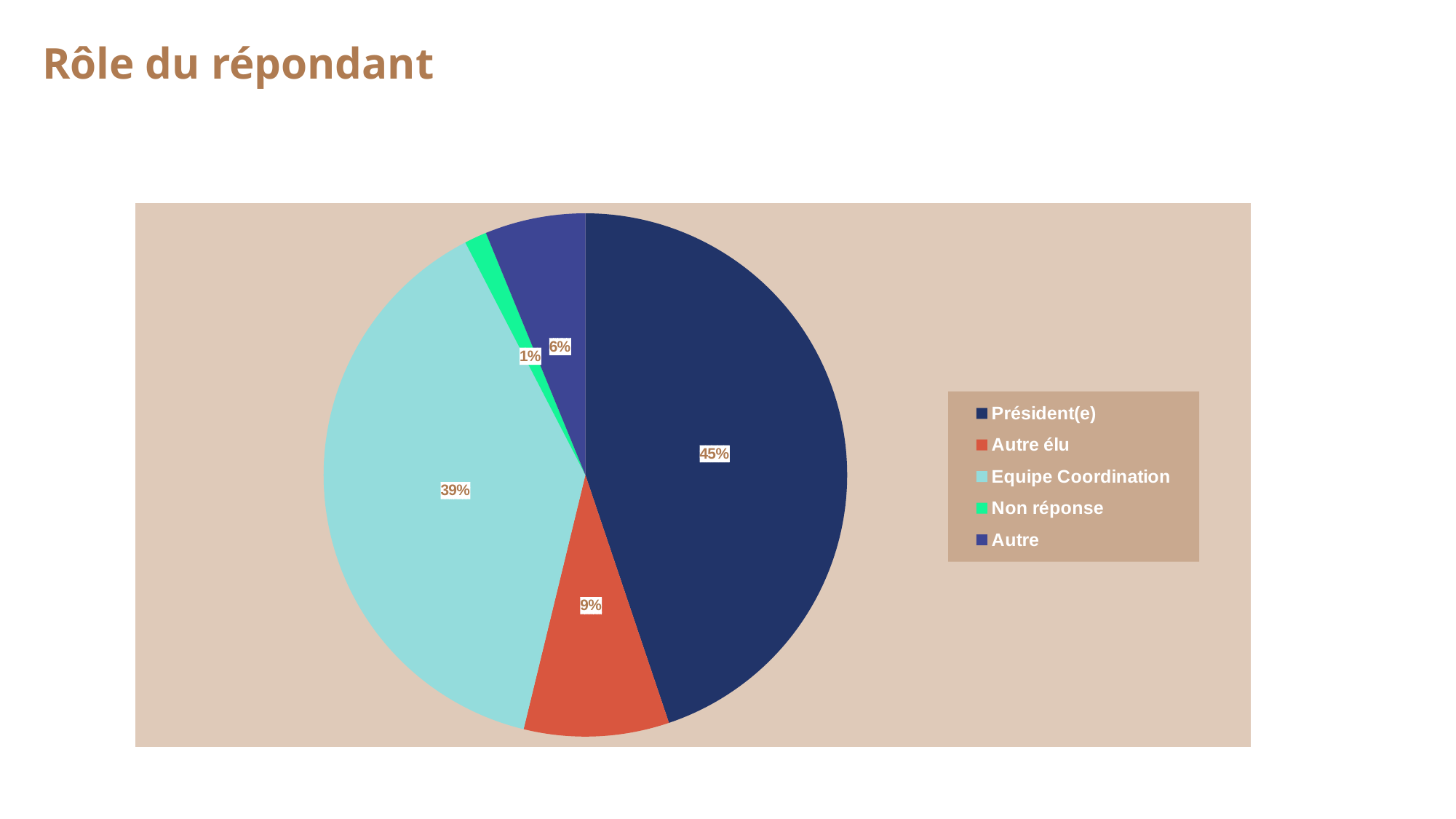
What is the difference in percentage points between Président(e) and Equipe Coordination? 6 What is the title of the slide containing the chart? Rôle du répondant What share of the pie does Président(e) represent? 45% What share of the pie does Equipe Coordination represent? 39% What type of chart is shown on the slide? pie chart What share of the pie does Non réponse represent? 1% How many categories does the legend list? 5 Which is larger, the share for Autre élu or the share for Autre? Autre élu Which category has the largest slice of the pie? Président(e) Which category has the smallest slice of the pie? Non réponse